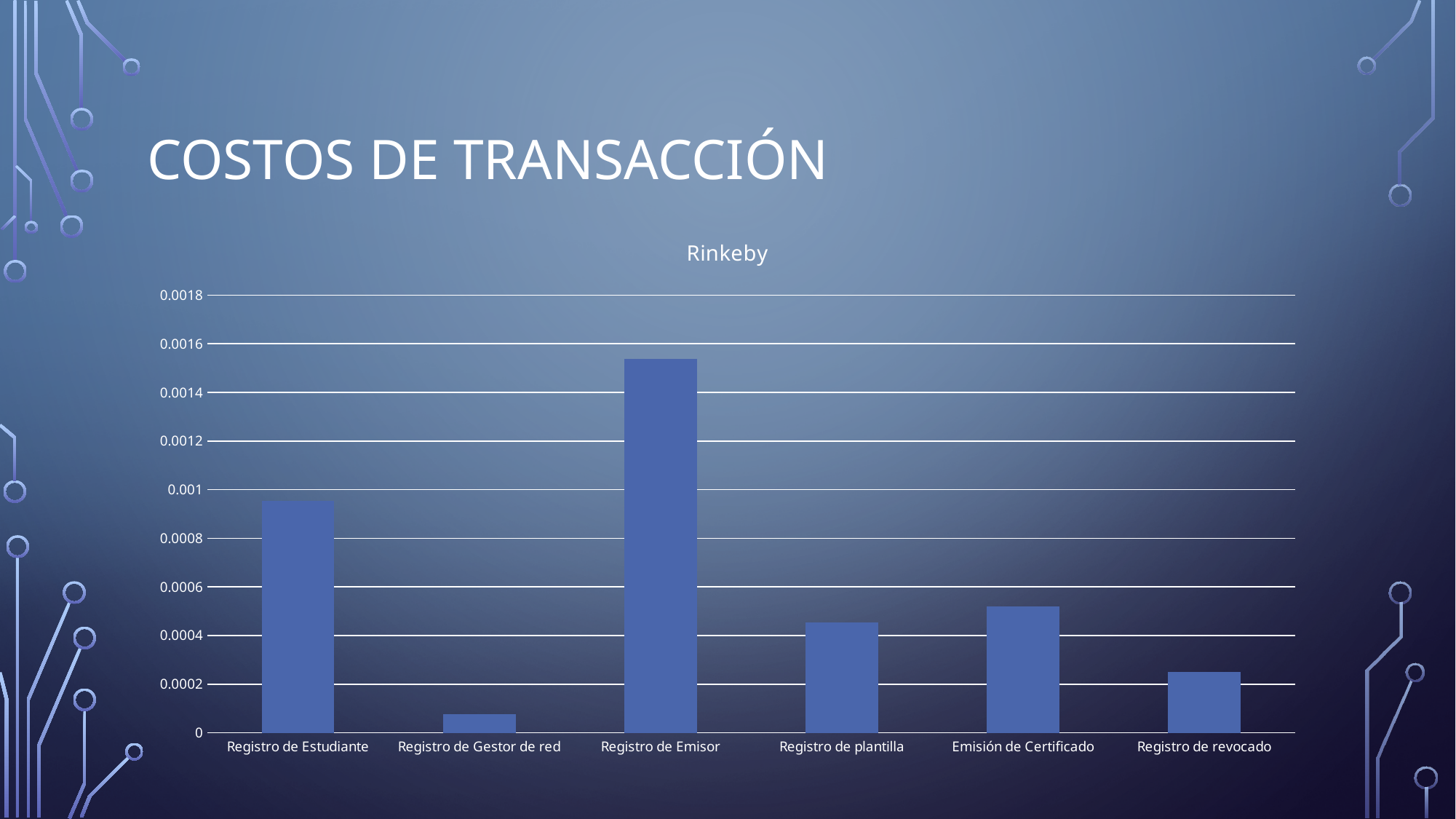
How many categories are shown on the x axis of the chart? 6 What type of chart is shown on the slide? bar chart Which category has the lowest value in the chart? Registro de Gestor de red What is the title of the chart? Rinkeby Is the value for Registro de Gestor de red greater or less than 0.0002? less Which category has the highest value in the chart? Registro de Emisor Is the value for Registro de Estudiante greater or less than 0.001? less Which is larger, the value for Registro de plantilla or the value for Registro de revocado? Registro de plantilla Is the value for Registro de Emisor greater or less than 0.0014? greater Which is larger, the value for Registro de Estudiante or the value for Emisión de Certificado? Registro de Estudiante